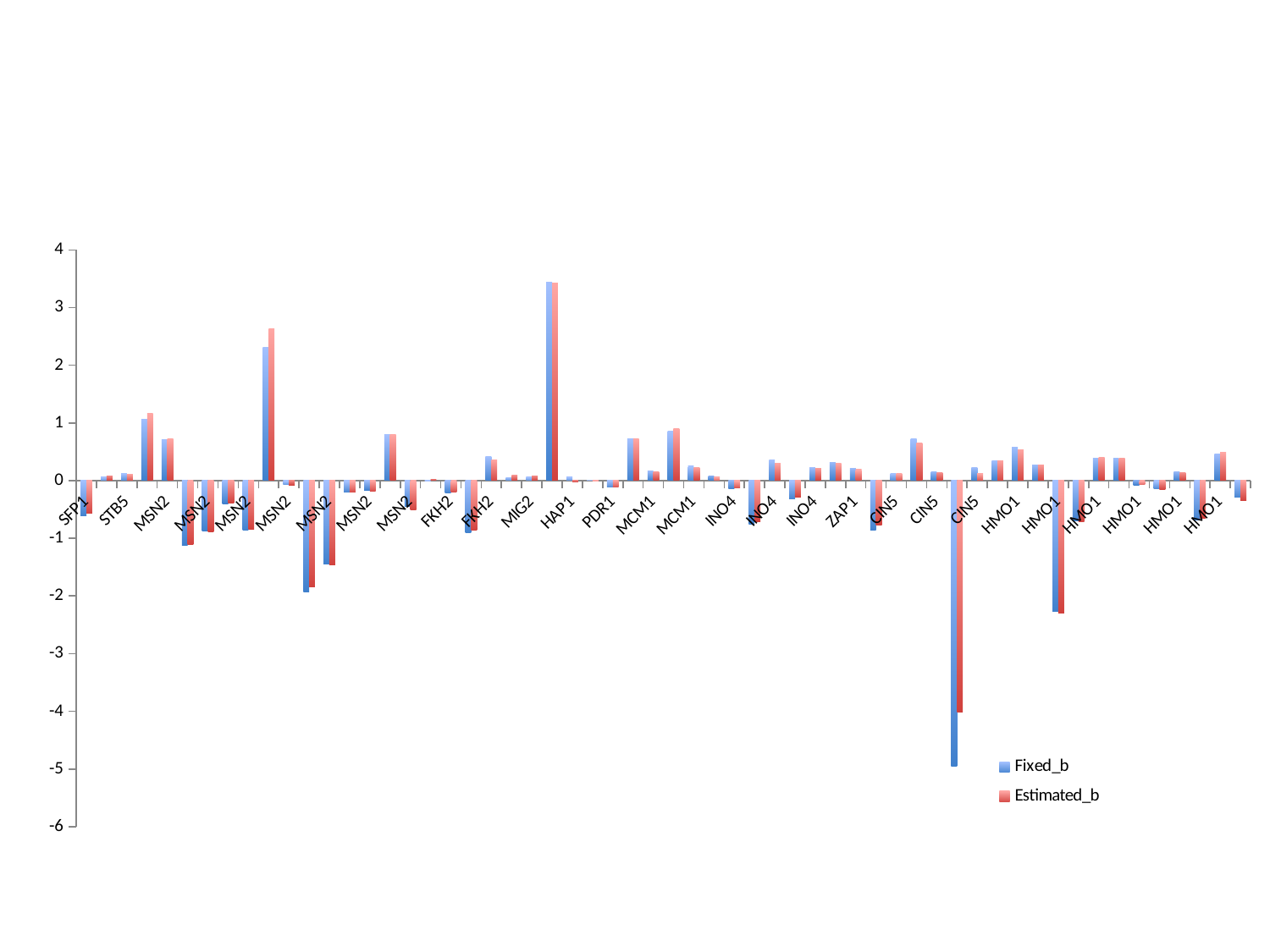
What are the two series named in the legend? Fixed_b and Estimated_b Is the Fixed_b value for SFP1 greater or less than 0? less Is the lowest Fixed_b value on the chart greater or less than -4? less Which colour represents the Estimated_b series? red Is the Estimated_b value for HAP1 greater or less than 3? greater What is the highest value shown on the vertical axis? 4 Which labelled category has the highest bars on the chart? HAP1 Which series contains the lowest bar on the chart? Fixed_b How many series does the legend list? 2 What kind of chart is shown on the slide? bar chart